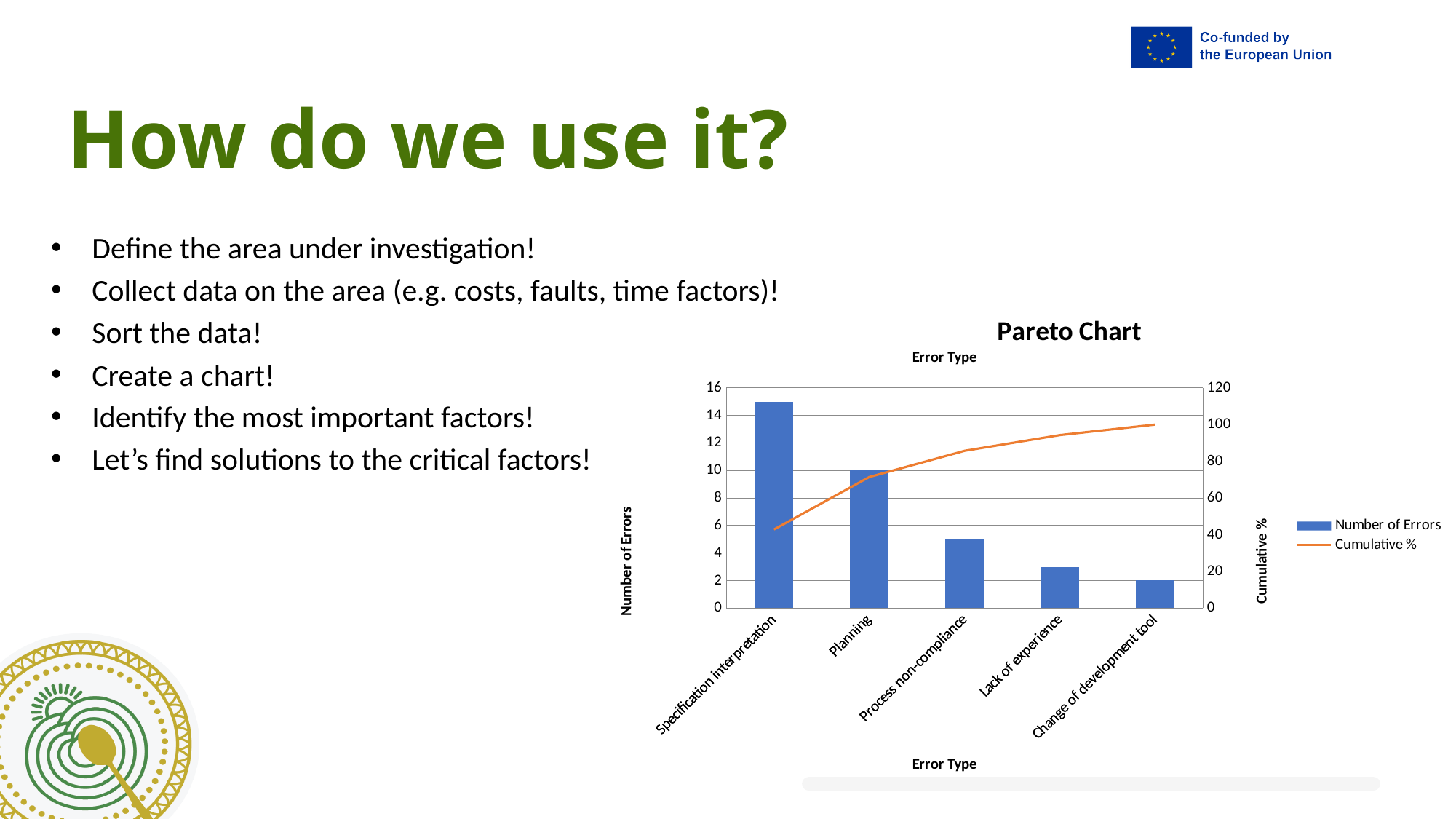
How many error type categories are shown on the x axis of the Pareto Chart? 5 Is the number of errors for Process non-compliance greater or less than 6? less What is the number of errors for Planning? 10 Which has more errors, Planning or Lack of experience? Planning Which error type has the highest number of errors? Specification interpretation Is the number of errors for Specification interpretation greater or less than 14? greater How many series does the legend of the Pareto Chart list? 2 Which error type has the lowest number of errors? Change of development tool What is the difference in number of errors between Planning and Change of development tool? 8 What is the number of errors for Change of development tool? 2 Do the Number of Errors bars rise or fall from left to right along the x axis? fall What kind of chart is shown on the slide? bar chart with a line